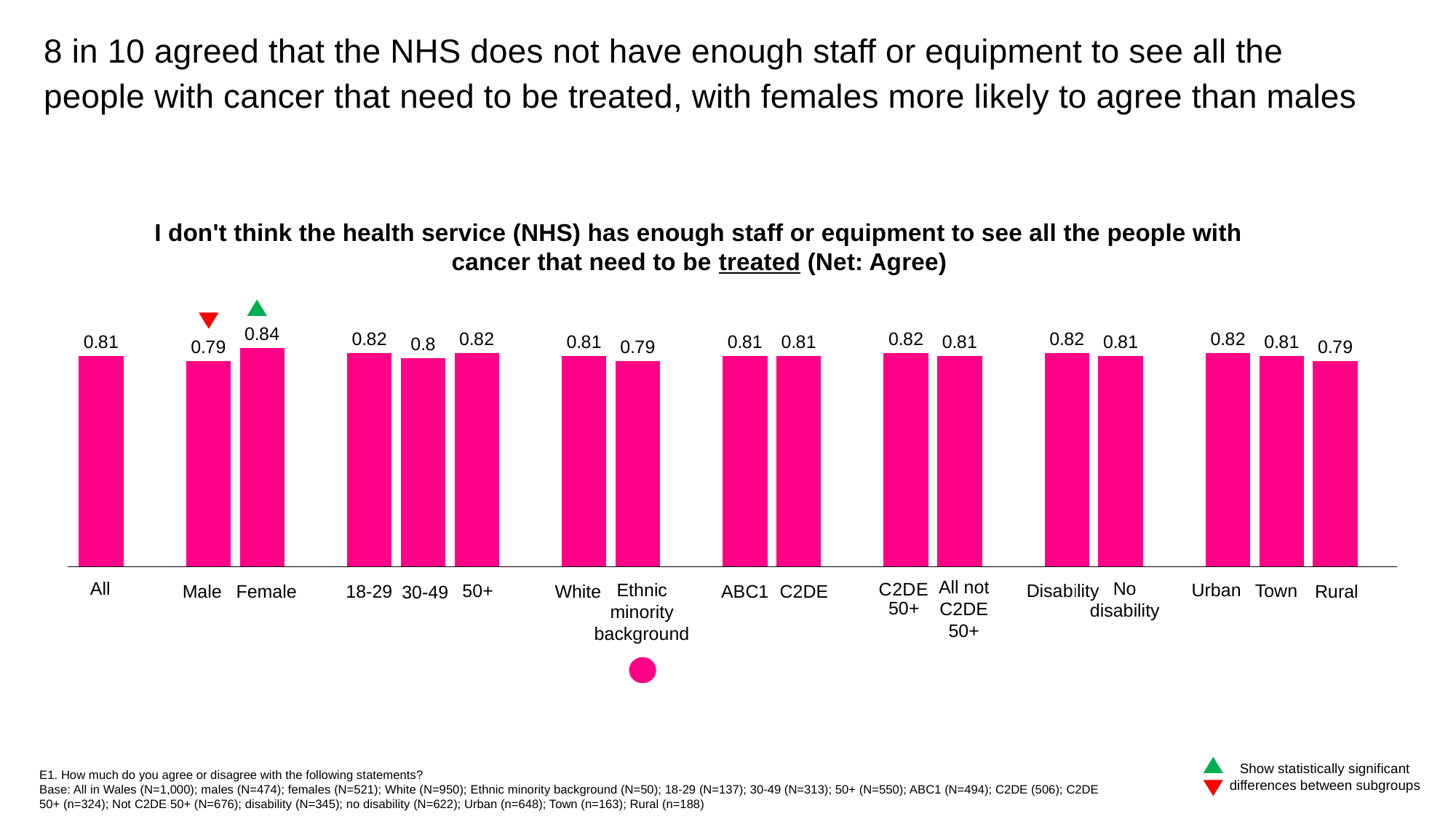
Which category has the highest value? Female What is the value for Male? 0.79 What is the value for Female? 0.84 What is the value for 30-49? 0.8 What is the value for Ethnic minority background? 0.79 What is the value for Rural? 0.79 What is the difference between the values for Female and Male? 0.05 What is the value for All? 0.81 What do the green and red triangles above the bars indicate? Statistically significant differences between subgroups How many bars are plotted in the chart? 17 What kind of chart is shown? Bar chart Which is larger, the value for Female or the value for Male? Female